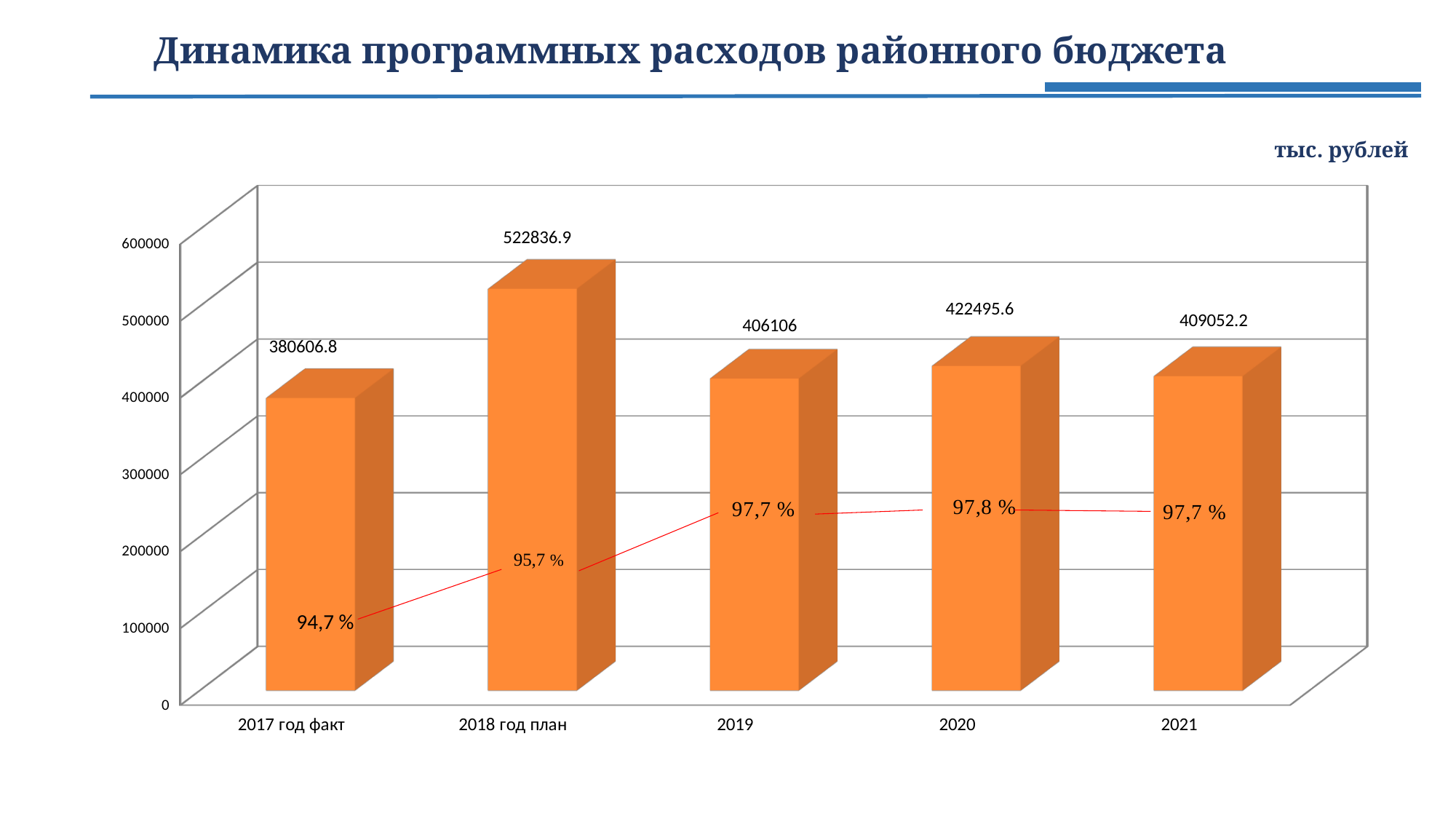
Which is larger, the value for 2020 or the value for 2019? 2020 What is the value for 2020? 422495.6 What is the value for 2018 год план? 522836.9 How many categories are shown on the x axis? 5 What is the value for 2017 год факт? 380606.8 Which category has the lowest value? 2017 год факт What is the title of the chart? Динамика программных расходов районного бюджета What percentage is shown for 2019? 97,7 % What is the difference between the values for 2020 and 2021? 13443.4 What kind of chart is shown on the slide? Bar chart Which category has the highest value? 2018 год план What is the difference between the values for 2018 год план and 2017 год факт? 142230.1